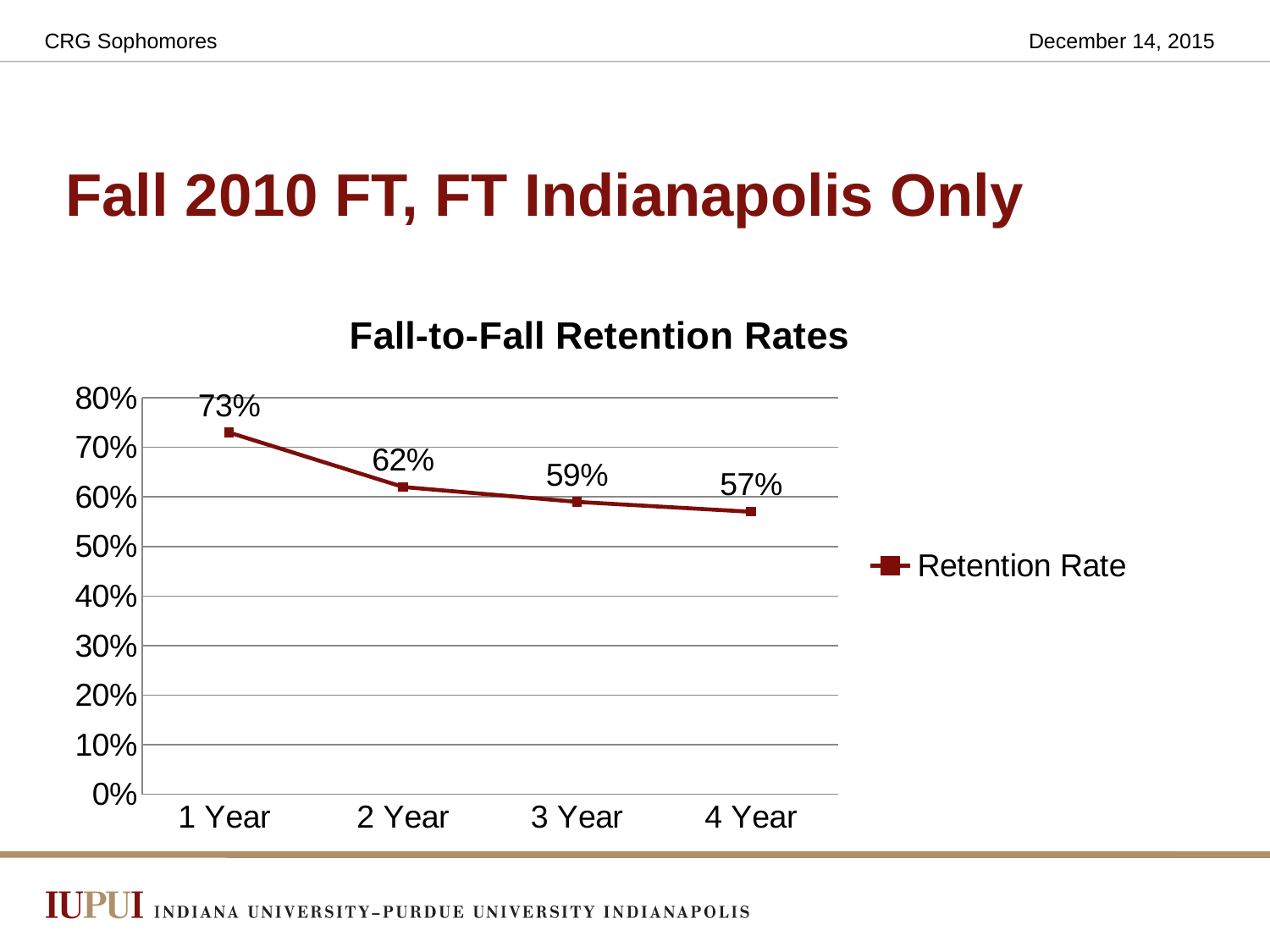
How many series does the legend list? 1 What is the difference in retention rate between 1 Year and 4 Year? 16% What is the retention rate at 3 Year? 59% Do the retention rates rise or fall from 1 Year to 4 Year? Fall Which category has the lowest retention rate? 4 Year What is the retention rate at 1 Year? 73% What kind of chart is shown? Line chart How many categories are shown on the x axis? 4 Which has a higher retention rate, 2 Year or 3 Year? 2 Year What is the retention rate at 4 Year? 57% Which category has the highest retention rate? 1 Year What is the retention rate at 2 Year? 62%